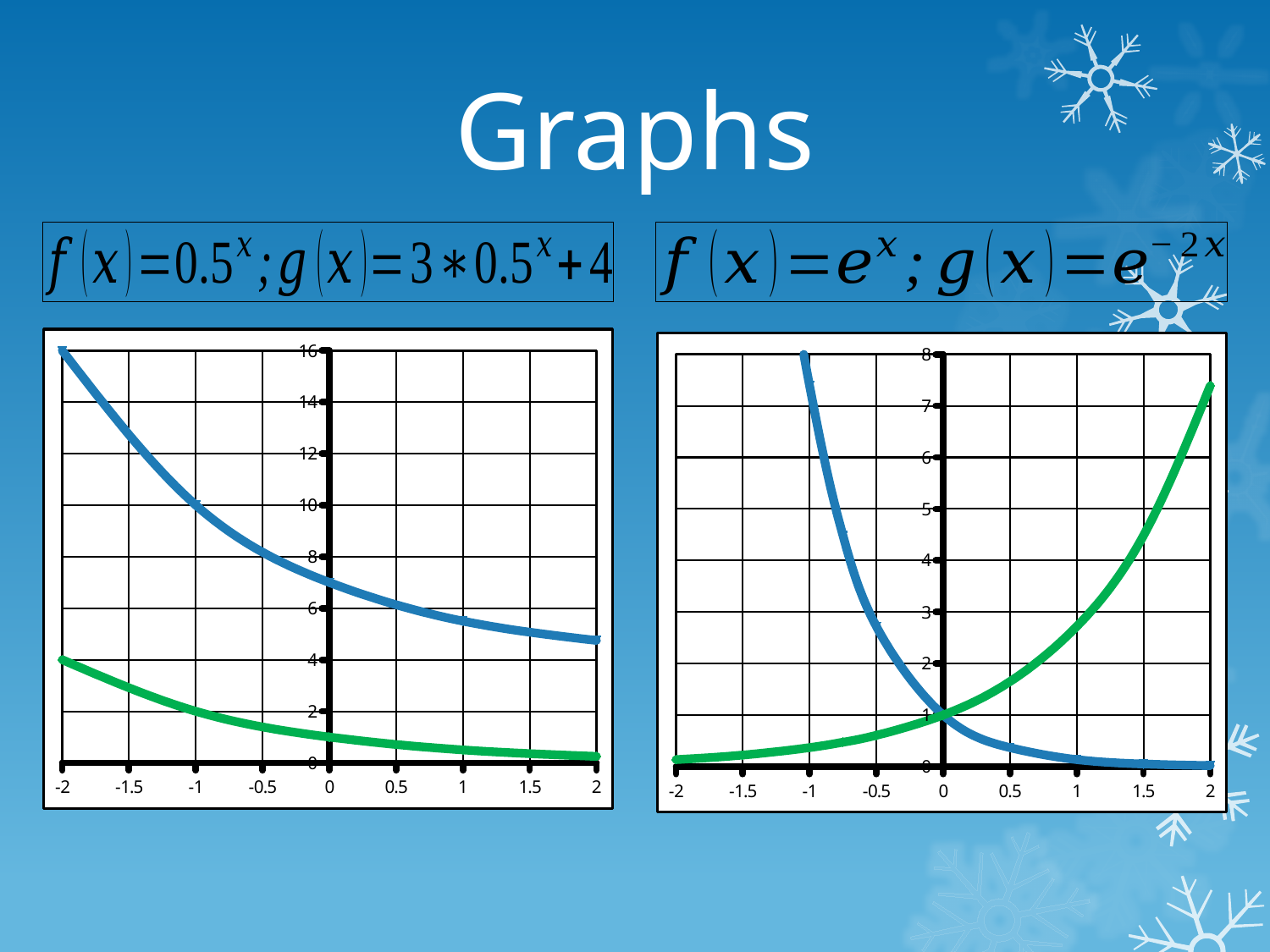
On the left chart (f(x)=0.5^x; g(x)=3*0.5^x+4), what is the value of the blue curve at x = -2? 16 On the right chart, at x = 1, which curve has the larger value, the green or the blue? green What kind of chart is the left chart on the slide? line chart On the left chart, do the curves rise or fall as x increases from -2 to 2? fall On the right chart (f(x)=e^x; g(x)=e^-2x), at what y value do the two curves cross at x = 0? 1 On the left chart, is the value of the green curve at x = 2 greater or less than 2? less On the left chart, is the value of the blue curve at x = 0 greater or less than 8? less How many curves are plotted on the right chart (f(x)=e^x; g(x)=e^-2x)? 2 On the left chart (f(x)=0.5^x; g(x)=3*0.5^x+4), what is the value of the green curve at x = -2? 4 On the right chart, is the value of the green curve at x = 2 greater or less than 7? greater On the right chart, does the green curve rise or fall as x increases from -2 to 2? rise